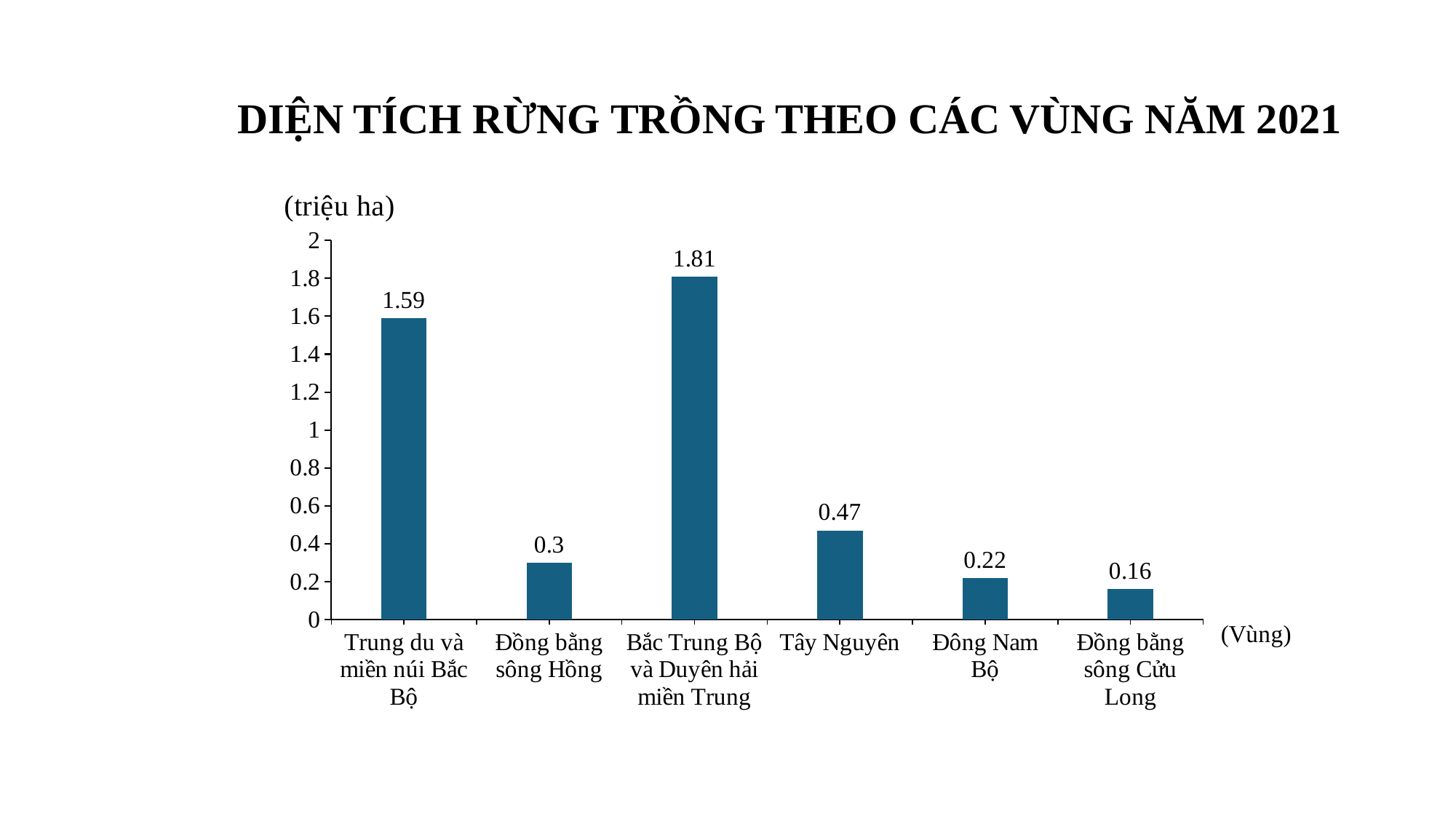
What is the difference between the values for Tây Nguyên and Đông Nam Bộ? 0.25 What value is shown for Đồng bằng sông Hồng? 0.3 What unit is shown on the vertical axis? triệu ha Which region has the largest planted forest area? Bắc Trung Bộ và Duyên hải miền Trung What is the planted forest area for Tây Nguyên? 0.47 What is the difference between the values for Bắc Trung Bộ và Duyên hải miền Trung and Trung du và miền núi Bắc Bộ? 0.22 Which region has the smallest planted forest area? Đồng bằng sông Cửu Long How many regions are shown on the chart? 6 What is the value for Đồng bằng sông Cửu Long? 0.16 What kind of chart is this? bar chart Which is larger, the value for Đông Nam Bộ or the value for Đồng bằng sông Hồng? Đồng bằng sông Hồng Is the value for Trung du và miền núi Bắc Bộ greater or less than 1? greater